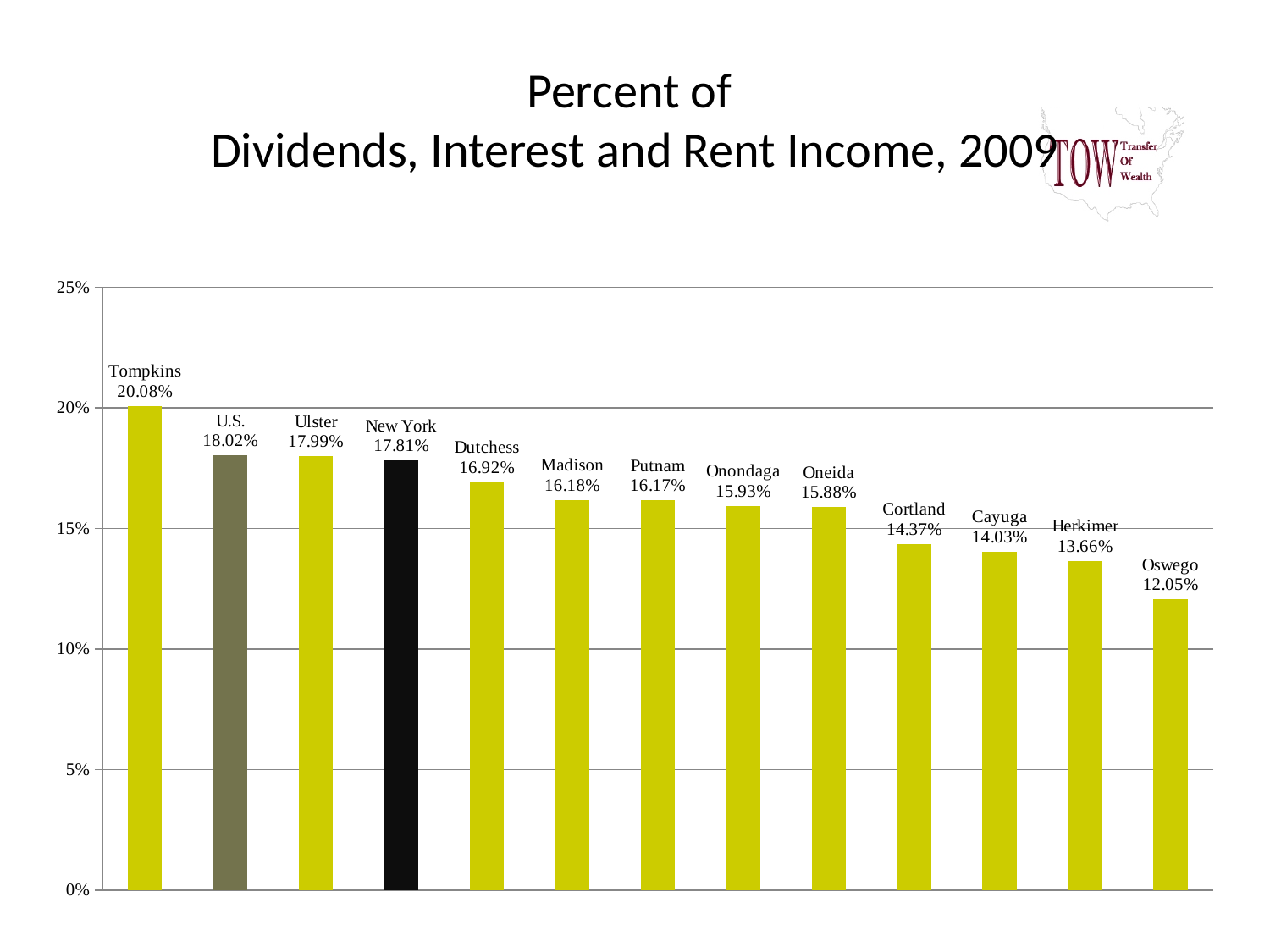
Is the value for Herkimer greater or less than 15%? less What is the difference between the values for U.S. and New York? 0.21% What is the difference between the values for Tompkins and Oswego? 8.03% Which is larger, the value for Dutchess or the value for Cortland? Dutchess What is the value for Tompkins? 20.08% How many bars are shown in the chart? 13 What kind of chart is shown on the slide? bar chart Do the values rise or fall from left to right along the x axis? fall What is the value for New York? 17.81% What is the value for Oneida? 15.88% Which category has the highest value? Tompkins Which category has the lowest value? Oswego